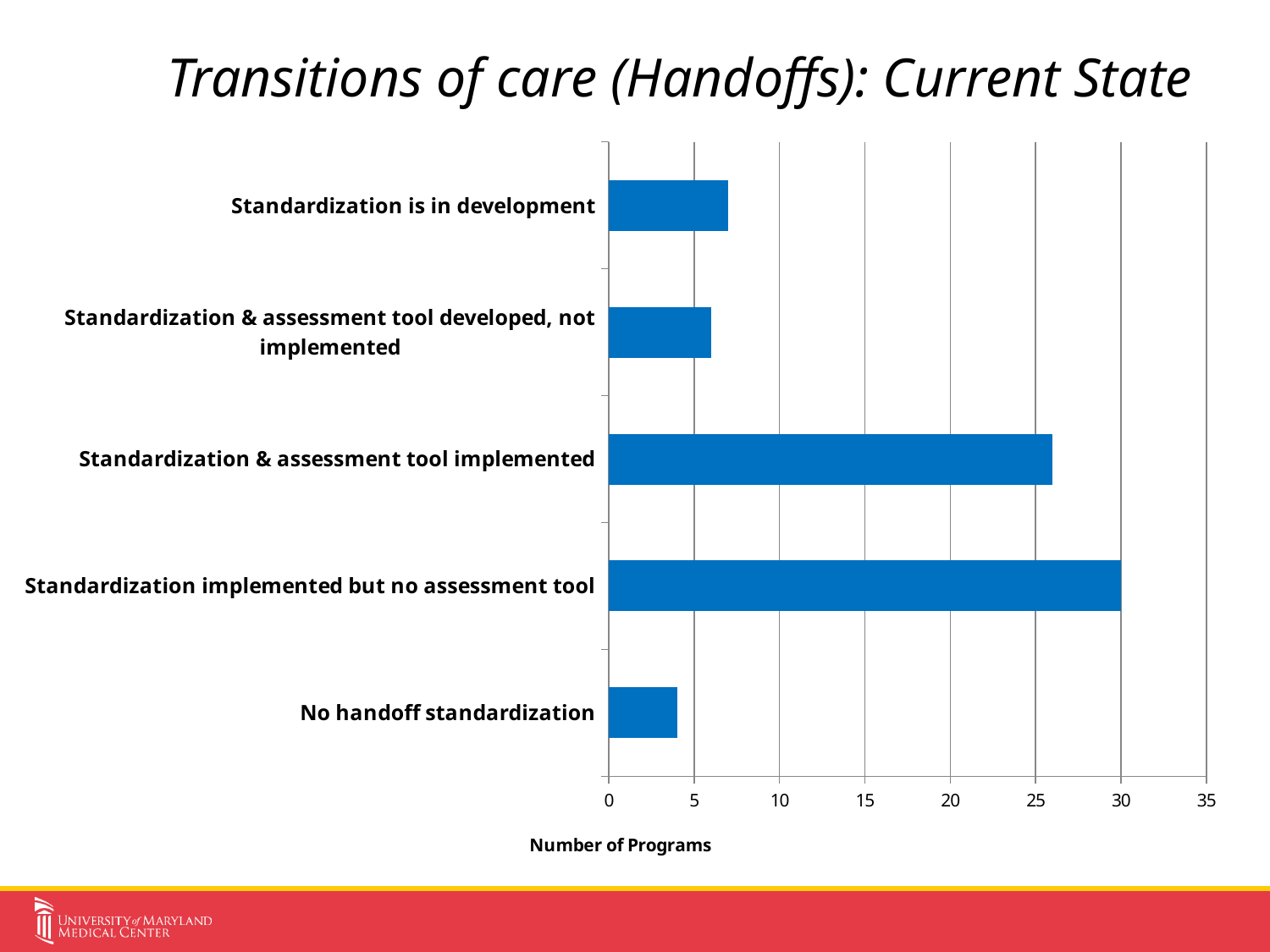
What is the title of the slide? Transitions of care (Handoffs): Current State How many categories are shown in the chart? 5 Is the value for 'Standardization & assessment tool developed, not implemented' greater or less than 10? less Which has more programs: 'Standardization & assessment tool implemented' or 'Standardization is in development'? Standardization & assessment tool implemented Is the value for 'Standardization is in development' greater or less than 10? less Is the value for 'Standardization & assessment tool implemented' greater or less than 25? greater What kind of chart is shown on the slide? bar chart What is the number of programs for 'Standardization implemented but no assessment tool'? 30 What is the title of the chart's horizontal axis? Number of Programs Which category has the lowest number of programs? No handoff standardization Which category has the highest number of programs? Standardization implemented but no assessment tool